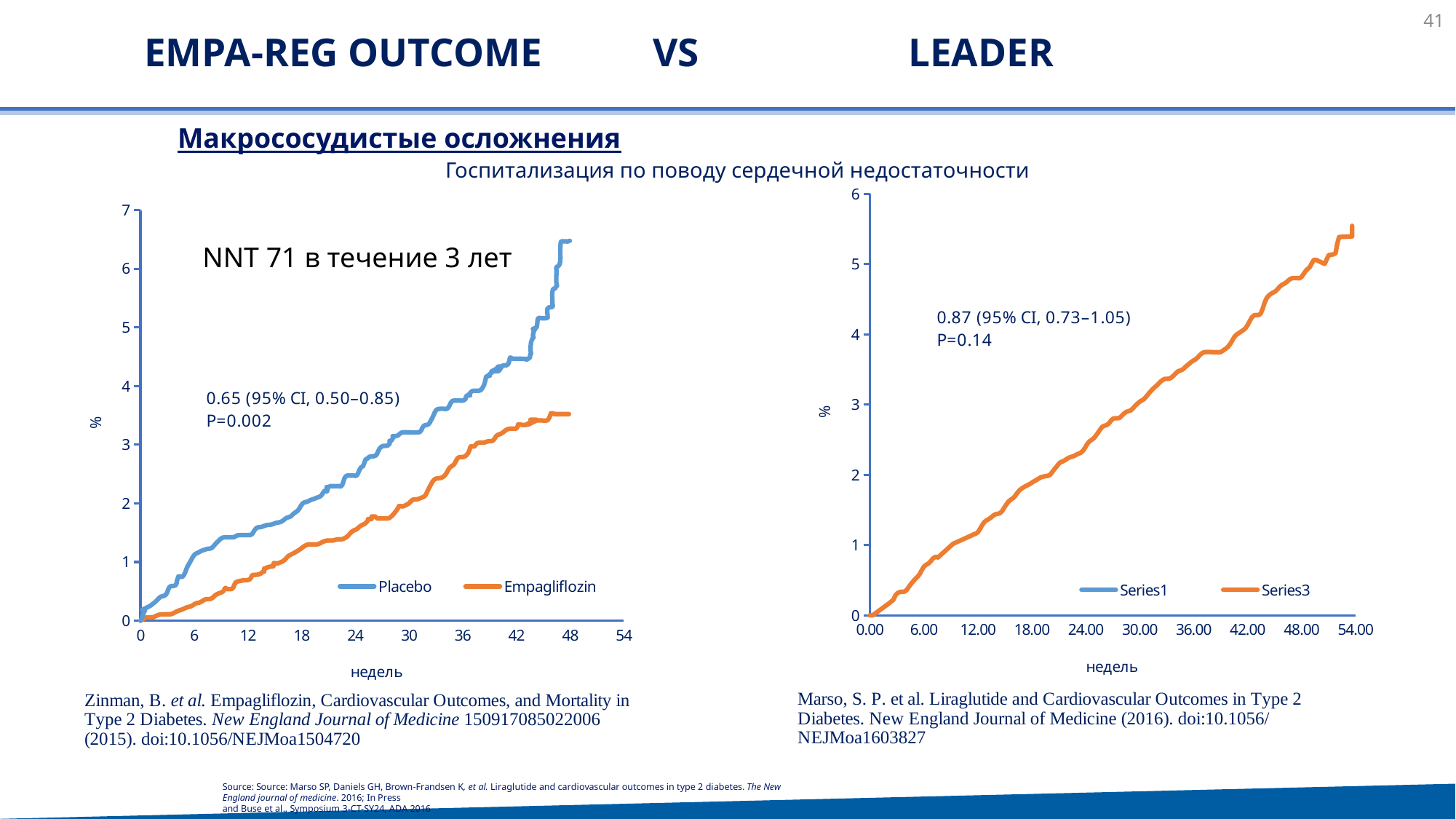
What are the two legend entries of the left chart (EMPA-REG OUTCOME)? Placebo and Empagliflozin What kind of chart is the left chart (EMPA-REG OUTCOME)? line chart How many series does the legend of the left chart (EMPA-REG OUTCOME) list? 2 What kind of chart is the right chart (LEADER)? line chart In the right chart (LEADER), do the values rise or fall as the weeks increase? rise How many series does the legend of the right chart (LEADER) list? 2 In the left chart (EMPA-REG OUTCOME), do the Placebo values rise or fall along the x axis? rise In the left chart (EMPA-REG OUTCOME), which series is higher at week 36, Placebo or Empagliflozin? Placebo What is the x-axis label of the right chart (LEADER)? недель In the left chart (EMPA-REG OUTCOME), is the final value of the Empagliflozin line greater or less than 4? less In the right chart (LEADER), is the value of the orange line at week 54 greater or less than 5? greater In the left chart (EMPA-REG OUTCOME), is the final value of the Placebo line greater or less than 6? greater